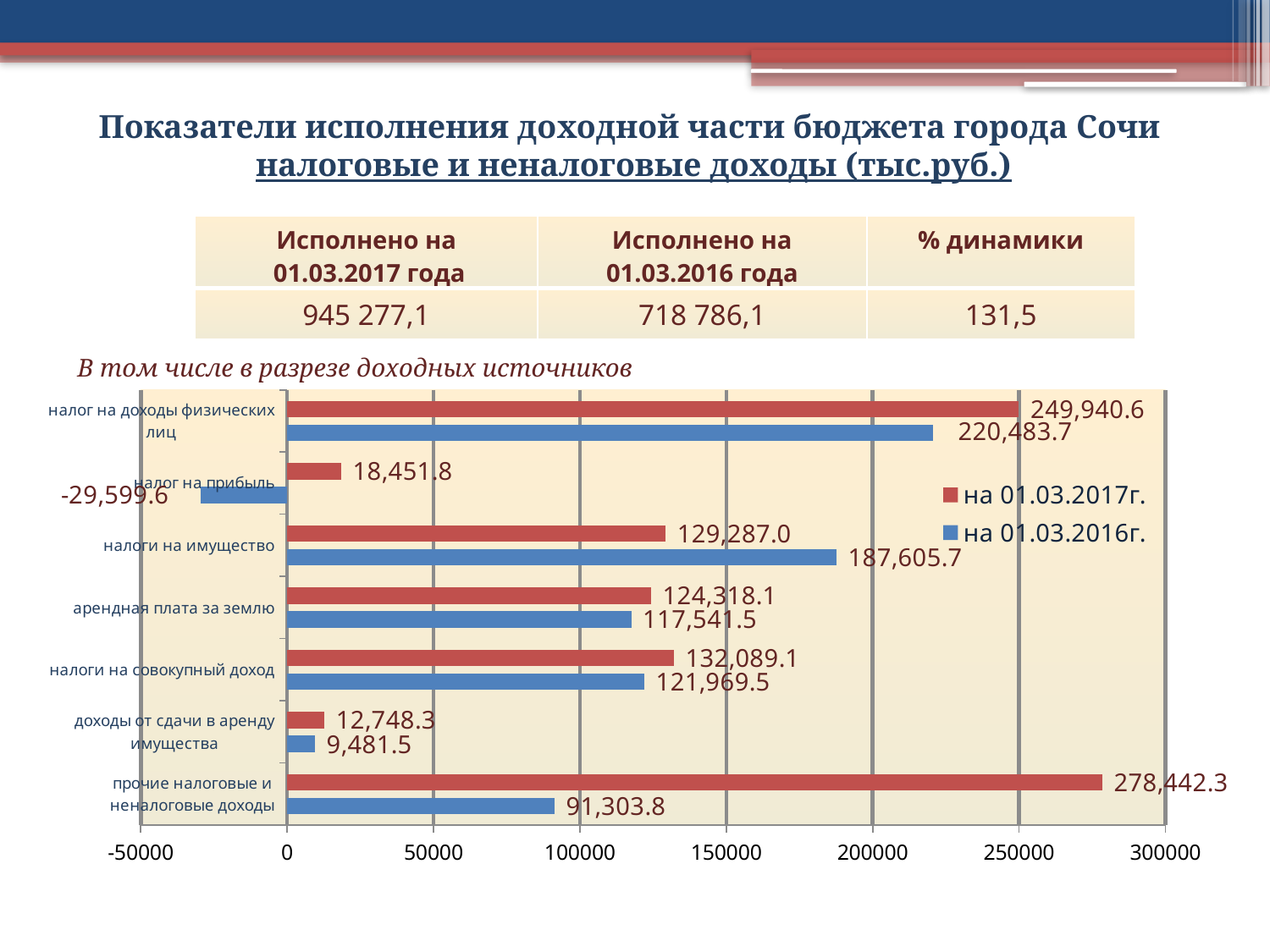
What is the value for налоги на имущество in the series на 01.03.2016г.? 187,605.7 Which category has the lowest value in the series на 01.03.2016г.? налог на прибыль What is the difference between the на 01.03.2017г. and на 01.03.2016г. values for прочие налоговые и неналоговые доходы? 187,138.5 Is the value for налоги на совокупный доход in the series на 01.03.2017г. greater or less than 100000? greater How many series does the legend list? 2 How many categories are shown on the chart? 7 For налоги на имущество, which series has the larger value: на 01.03.2017г. or на 01.03.2016г.? на 01.03.2016г. What kind of chart is shown on the slide? bar chart What is the difference between the на 01.03.2016г. and на 01.03.2017г. values for налоги на имущество? 58,318.7 What is the value for налог на доходы физических лиц in the series на 01.03.2017г.? 249,940.6 What is the value for налог на прибыль in the series на 01.03.2016г.? -29,599.6 Which category has the highest value in the series на 01.03.2017г.? прочие налоговые и неналоговые доходы